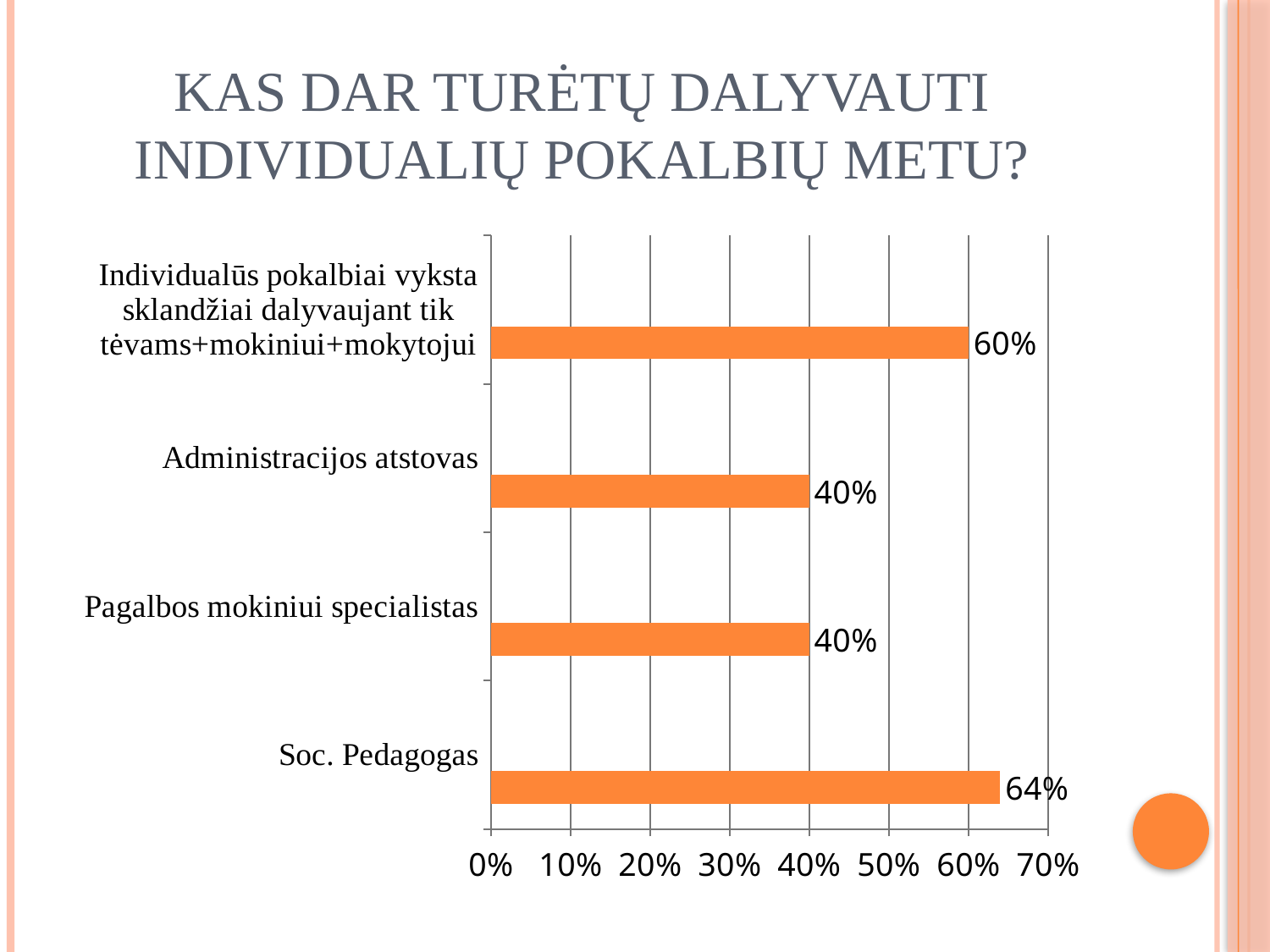
Which category has the highest value? Soc. Pedagogas Is the value for Soc. Pedagogas greater or less than 50%? greater What is the value for 'Individualūs pokalbiai vyksta sklandžiai dalyvaujant tik tėvams+mokiniui+mokytojui'? 60% What is the difference between the values for Soc. Pedagogas and 'Individualūs pokalbiai vyksta sklandžiai dalyvaujant tik tėvams+mokiniui+mokytojui'? 4% What is the difference between the values for Soc. Pedagogas and Administracijos atstovas? 24% What is the value for Pagalbos mokiniui specialistas? 40% Which is larger: the value for Soc. Pedagogas or the value for Pagalbos mokiniui specialistas? Soc. Pedagogas What is the highest value shown on the x axis? 70% How many categories are shown in the chart? 4 What kind of chart is shown on the slide? Bar chart What is the value for Soc. Pedagogas? 64% What is the value for Administracijos atstovas? 40%